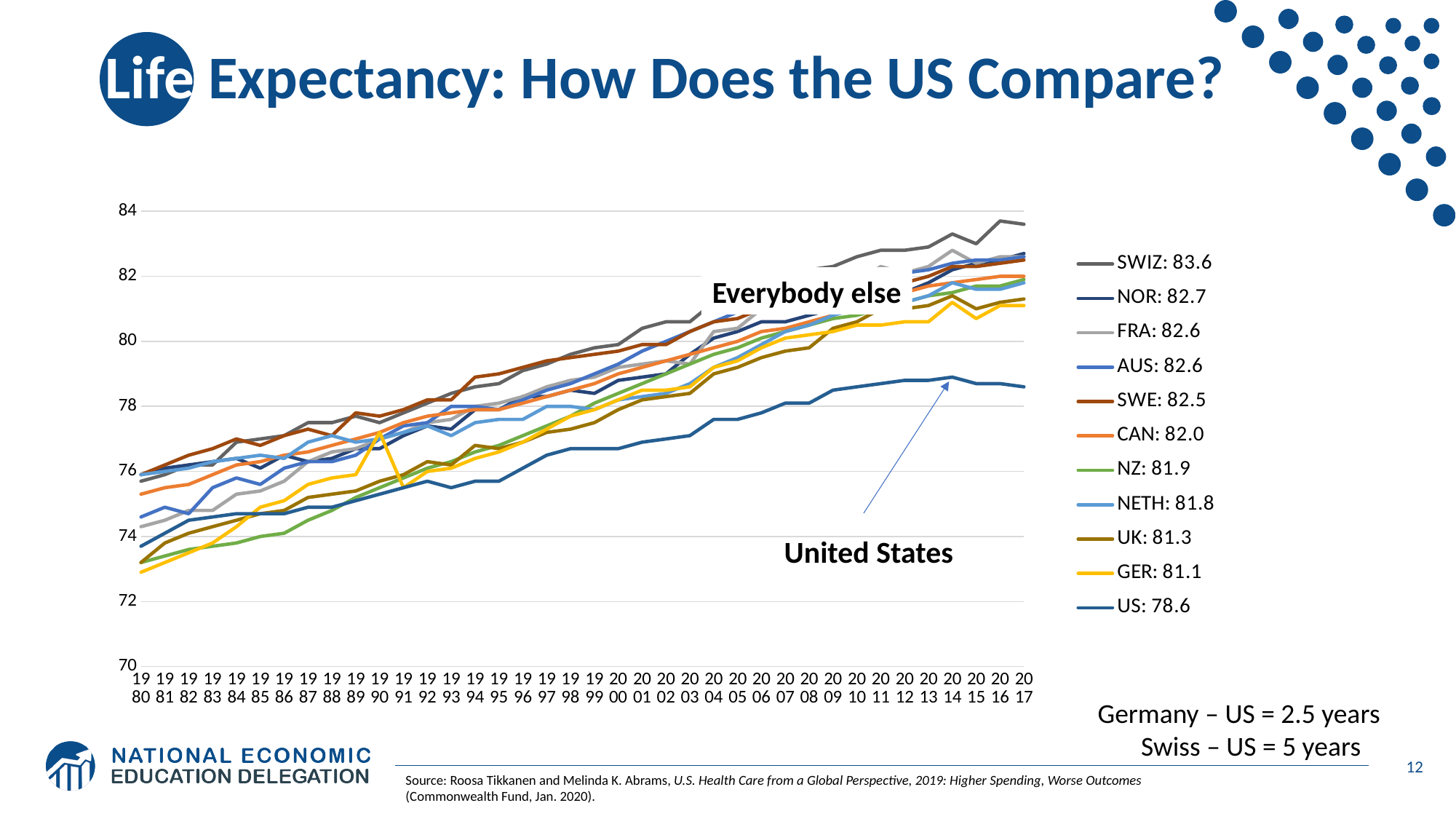
What is the difference between the SWIZ value and the US value in the legend? 5 years Which country has the highest life expectancy value in the legend? SWIZ Which has a higher legend value, NOR or CAN? NOR Is the value for the US line in 1980 greater or less than 74? less How many series does the legend list? 11 According to the legend, what is the life expectancy value for SWIZ? 83.6 According to the legend, what is the life expectancy value for the US? 78.6 According to the legend, what is the life expectancy value for GER? 81.1 Does the US line generally rise or fall from 1980 to 2017? rise Which country has the lowest life expectancy value in the legend? US What is the difference between the GER value and the US value in the legend? 2.5 years What type of chart is shown on the slide? line chart